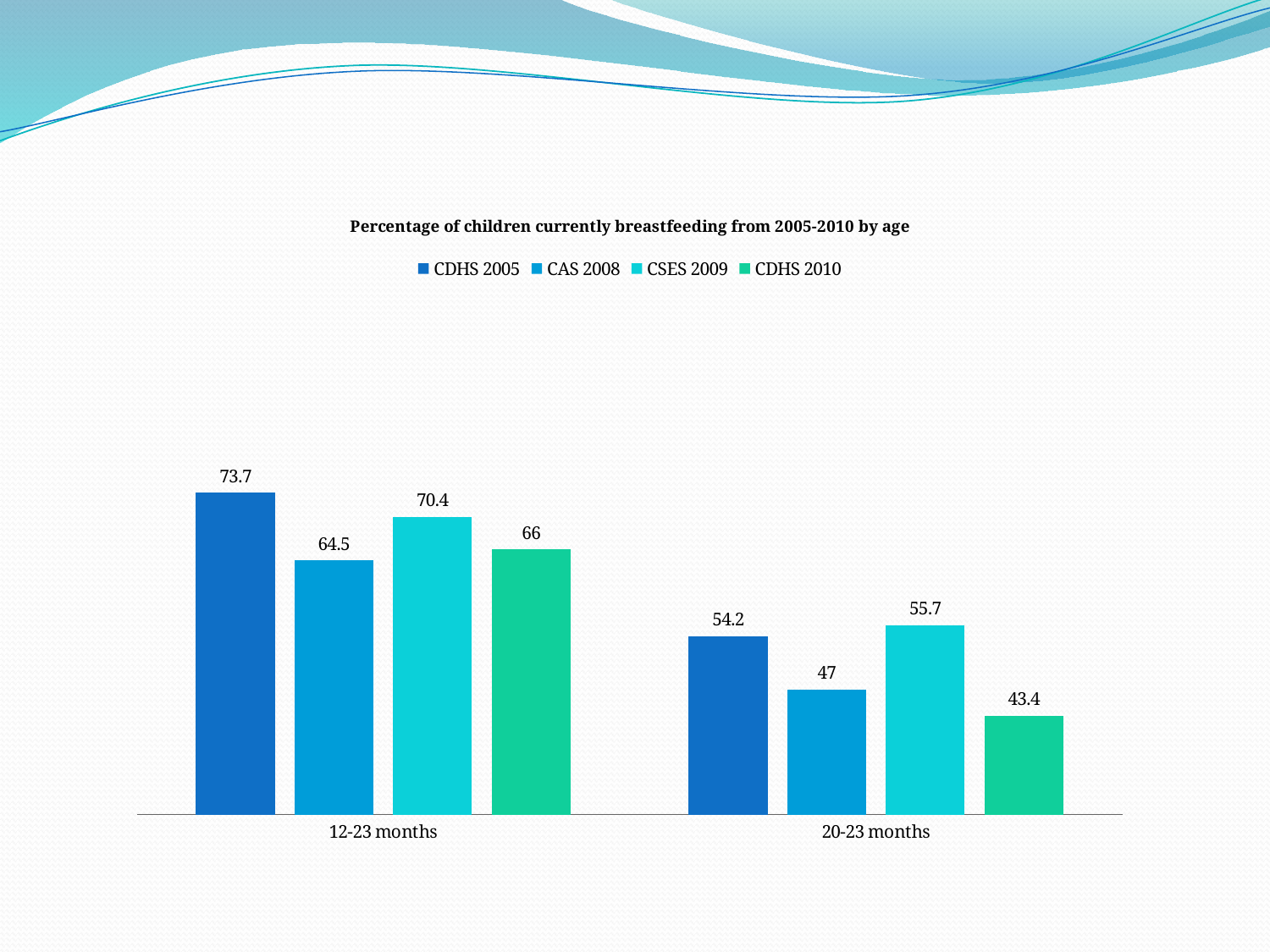
Which series has the lowest value in the 12-23 months category? CAS 2008 Which series has the highest value in the 20-23 months category? CSES 2009 What is the value for CAS 2008 in the 20-23 months category? 47 How many series does the legend list? 4 What is the title of the chart? Percentage of children currently breastfeeding from 2005-2010 by age How many age categories are shown on the x axis? 2 What is the difference between CSES 2009 and CDHS 2010 in the 20-23 months category? 12.3 What kind of chart is shown on the slide? Bar chart What is the value for CDHS 2010 in the 12-23 months category? 66 What is the value for CDHS 2005 in the 12-23 months category? 73.7 What is the difference between the CDHS 2005 values for 12-23 months and 20-23 months? 19.5 Which is larger: CAS 2008 for 12-23 months or CDHS 2005 for 20-23 months? CAS 2008 for 12-23 months